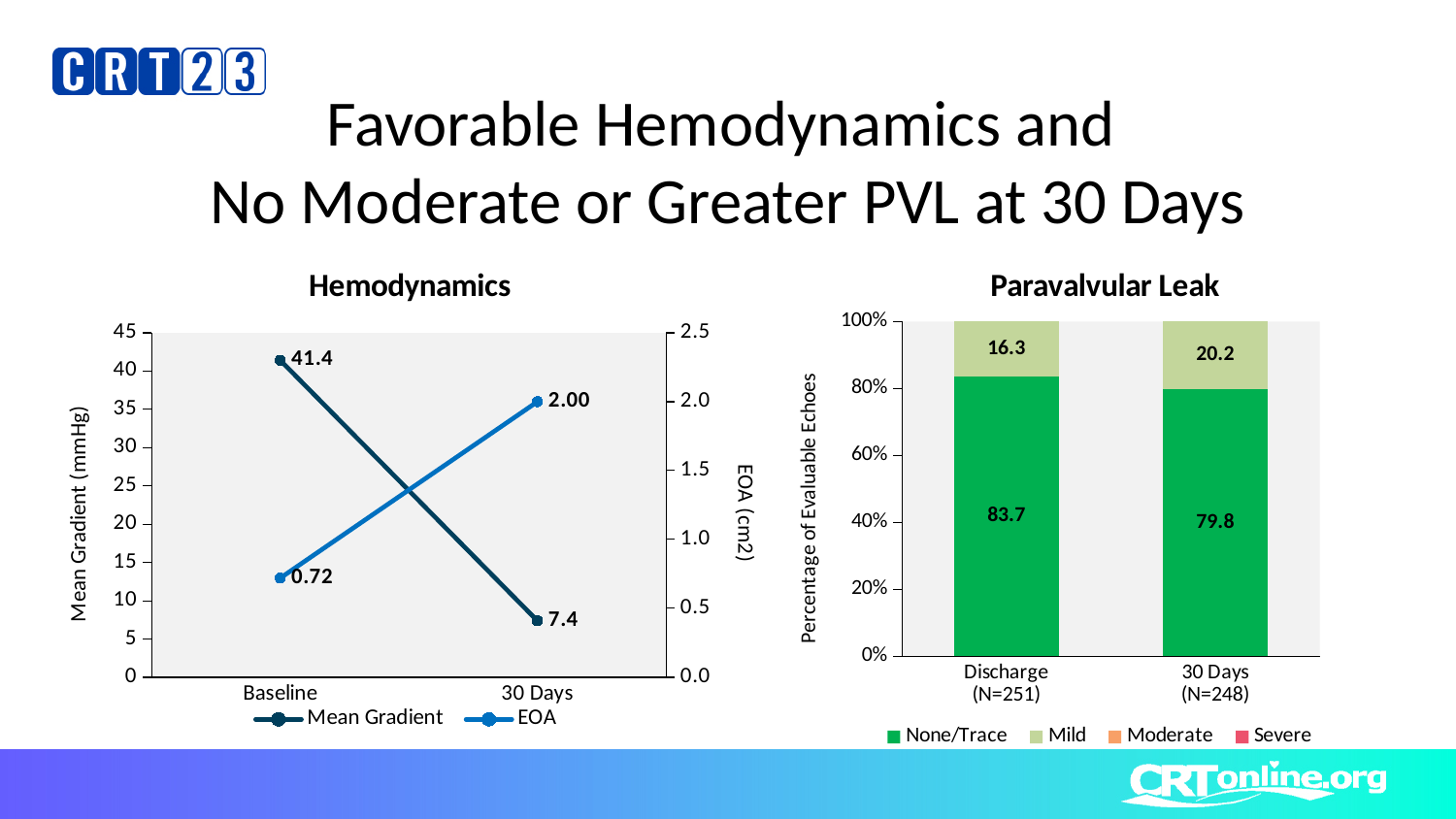
In the Hemodynamics chart, by how much does the Mean Gradient decrease from Baseline to 30 Days? 34.0 In the Hemodynamics chart, what is the Mean Gradient at 30 Days? 7.4 In the Paravalvular Leak chart, what percentage of evaluable echoes were Mild at 30 Days? 20.2 What kind of chart is the Paravalvular Leak chart? stacked bar chart In the Hemodynamics chart, how many series does the legend list? 2 In the Hemodynamics chart, does the EOA rise or fall from Baseline to 30 Days? rise In the Paravalvular Leak chart, which time point has the larger Mild percentage, Discharge or 30 Days? 30 Days In the Hemodynamics chart, does the Mean Gradient rise or fall from Baseline to 30 Days? fall In the Paravalvular Leak chart, what percentage of evaluable echoes were None/Trace at Discharge? 83.7 In the Hemodynamics chart, what is the EOA at 30 Days? 2.00 In the Paravalvular Leak chart, how many series does the legend list? 4 In the Hemodynamics chart, what is the Mean Gradient at Baseline? 41.4